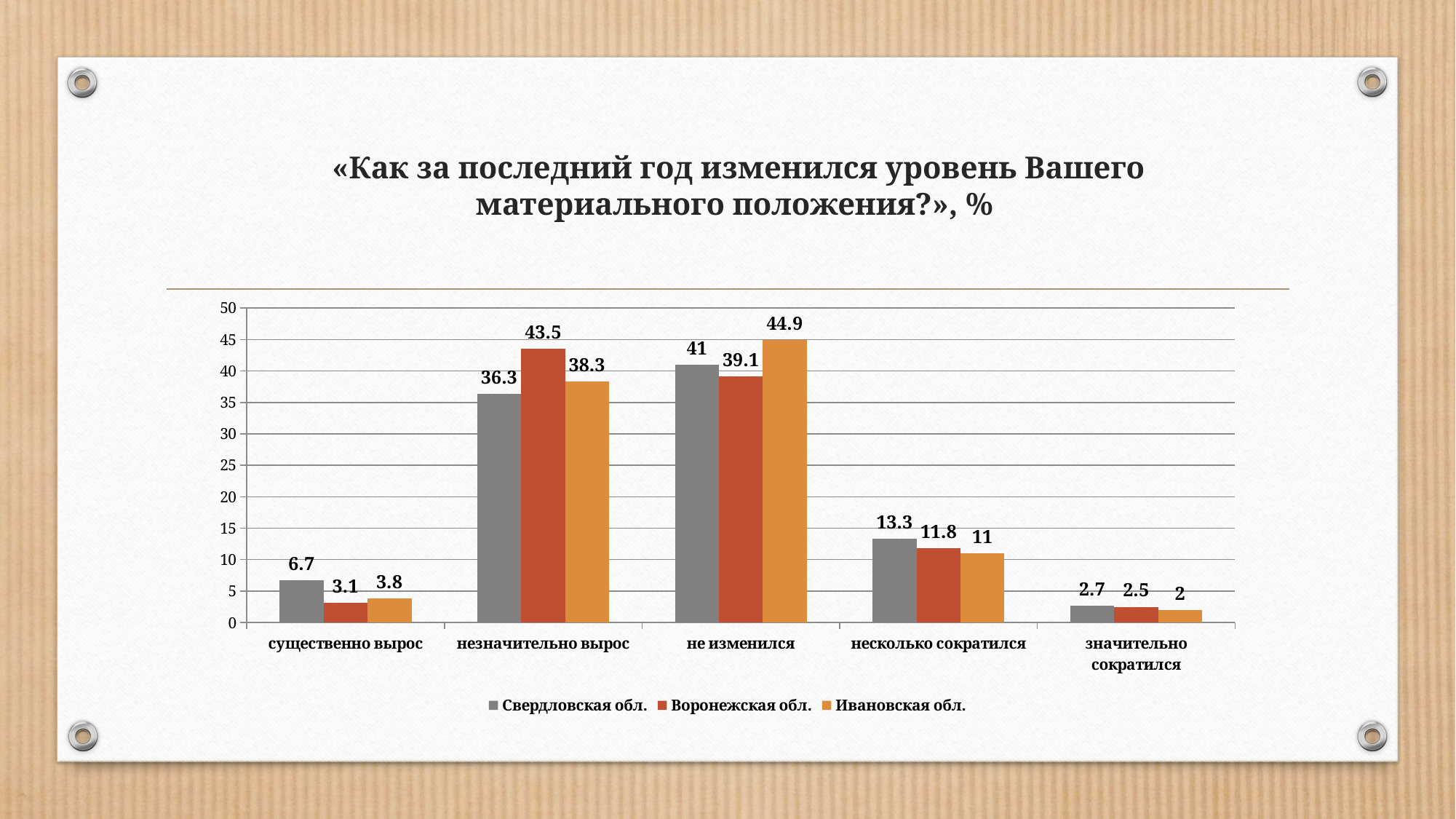
Is the value for Воронежская обл. in the category «незначительно вырос» greater or less than 40? greater How many series does the legend list? 3 What is the value for Воронежская обл. in the category «незначительно вырос»? 43.5 Which series is shown in grey in the legend? Свердловская обл. How many categories are shown on the x axis? 5 Which category has the lowest value for Ивановская обл.? значительно сократился Which is larger in the category «несколько сократился»: Свердловская обл. or Ивановская обл.? Свердловская обл. What is the difference between the Ивановская обл. and Свердловская обл. values in the category «не изменился»? 3.9 What kind of chart is shown on the slide? bar chart What is the value for Ивановская обл. in the category «не изменился»? 44.9 What is the value for Свердловская обл. in the category «существенно вырос»? 6.7 Which category has the highest value for Свердловская обл.? не изменился